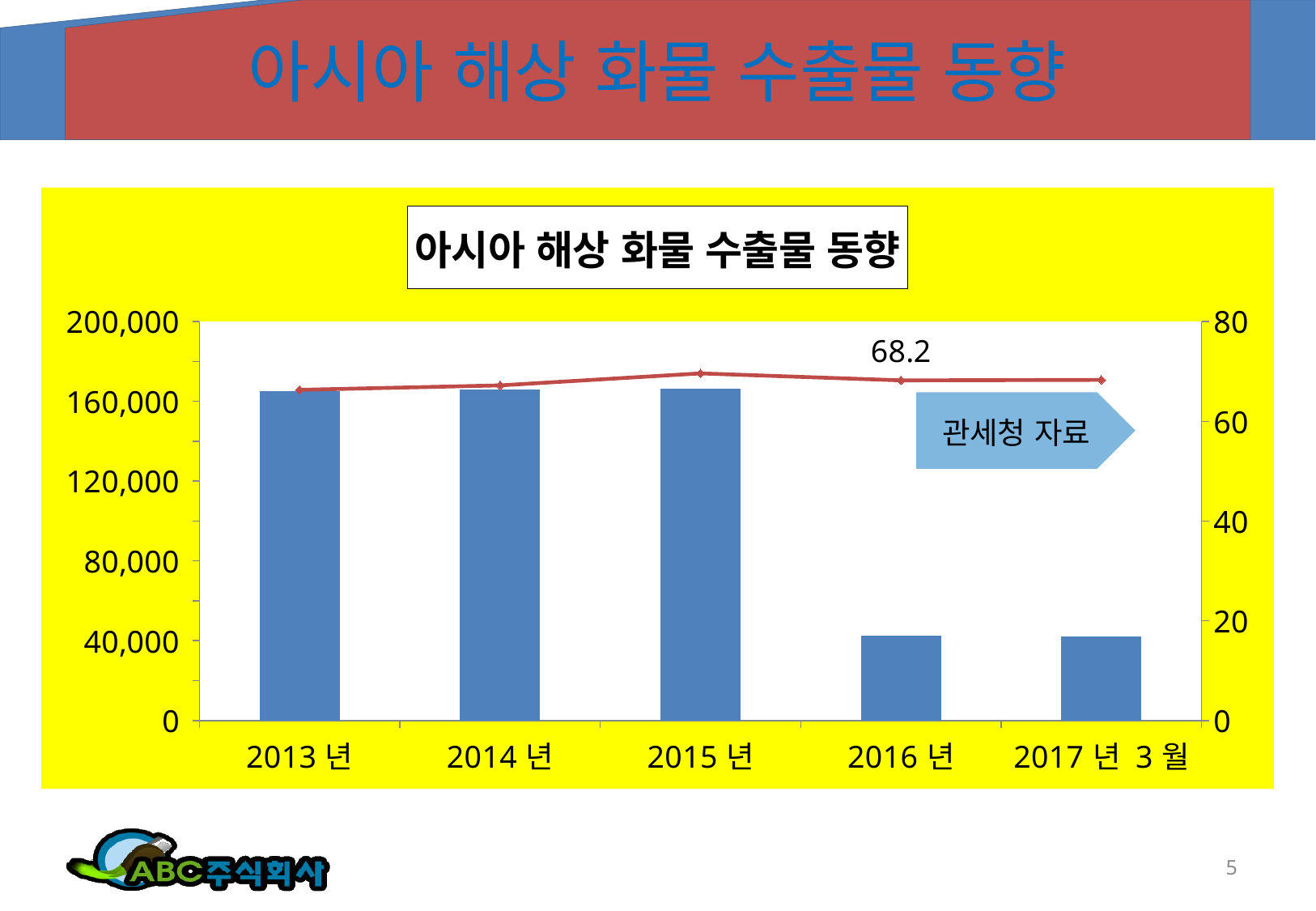
What is the title of the chart? 아시아 해상 화물 수출물 동향 How many categories are shown on the x axis of the chart? 5 Which has the larger bar value, 2015 년 or 2016 년? 2015 년 Is the bar value for 2013 년 greater or less than 120,000? greater What kind of chart is shown on the slide? bar and line chart Is the bar value for 2016 년 greater or less than 80,000? less What is the maximum value shown on the right-hand axis of the chart? 80 What value is labelled on the line for 2016 년? 68.2 Which has the larger bar value, 2014 년 or 2017 년 3 월? 2014 년 Do the bar values rise or fall from 2015 년 to 2016 년? fall Is the bar value for 2017 년 3 월 greater or less than 80,000? less